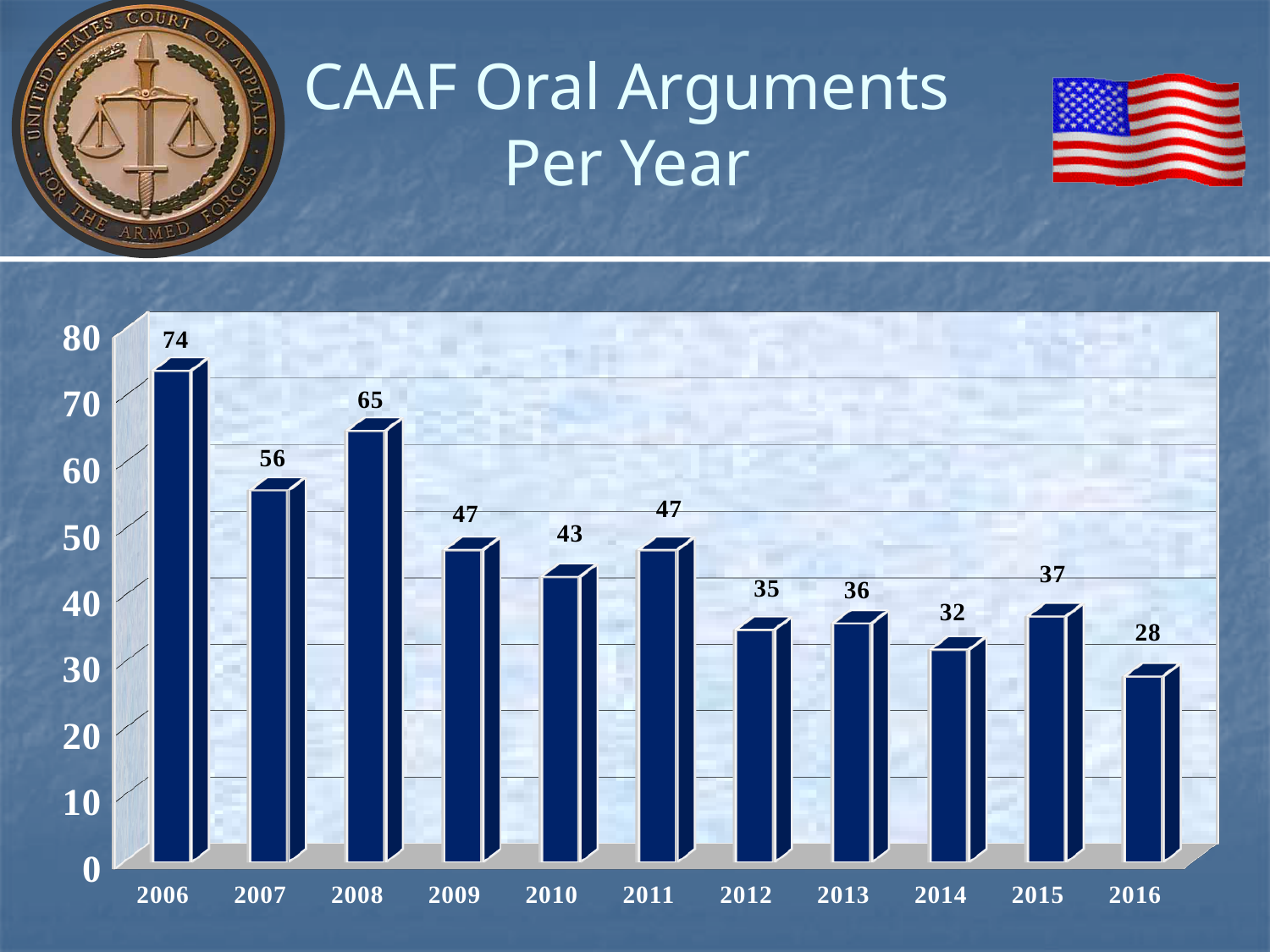
Which year has the highest number of oral arguments? 2006 Which is larger, the value for 2012 or the value for 2015? 2015 How many years are shown on the x axis? 11 What is the value for 2010? 43 Which year has the lowest number of oral arguments? 2016 What kind of chart is shown on the slide? bar chart Is the value for 2014 greater or less than 40? less What is the difference between the values for 2006 and 2016? 46 What is the difference between the values for 2008 and 2007? 9 Do the values generally rise or fall from 2006 to 2016? fall What is the value for 2016? 28 How many oral arguments were there in 2006? 74